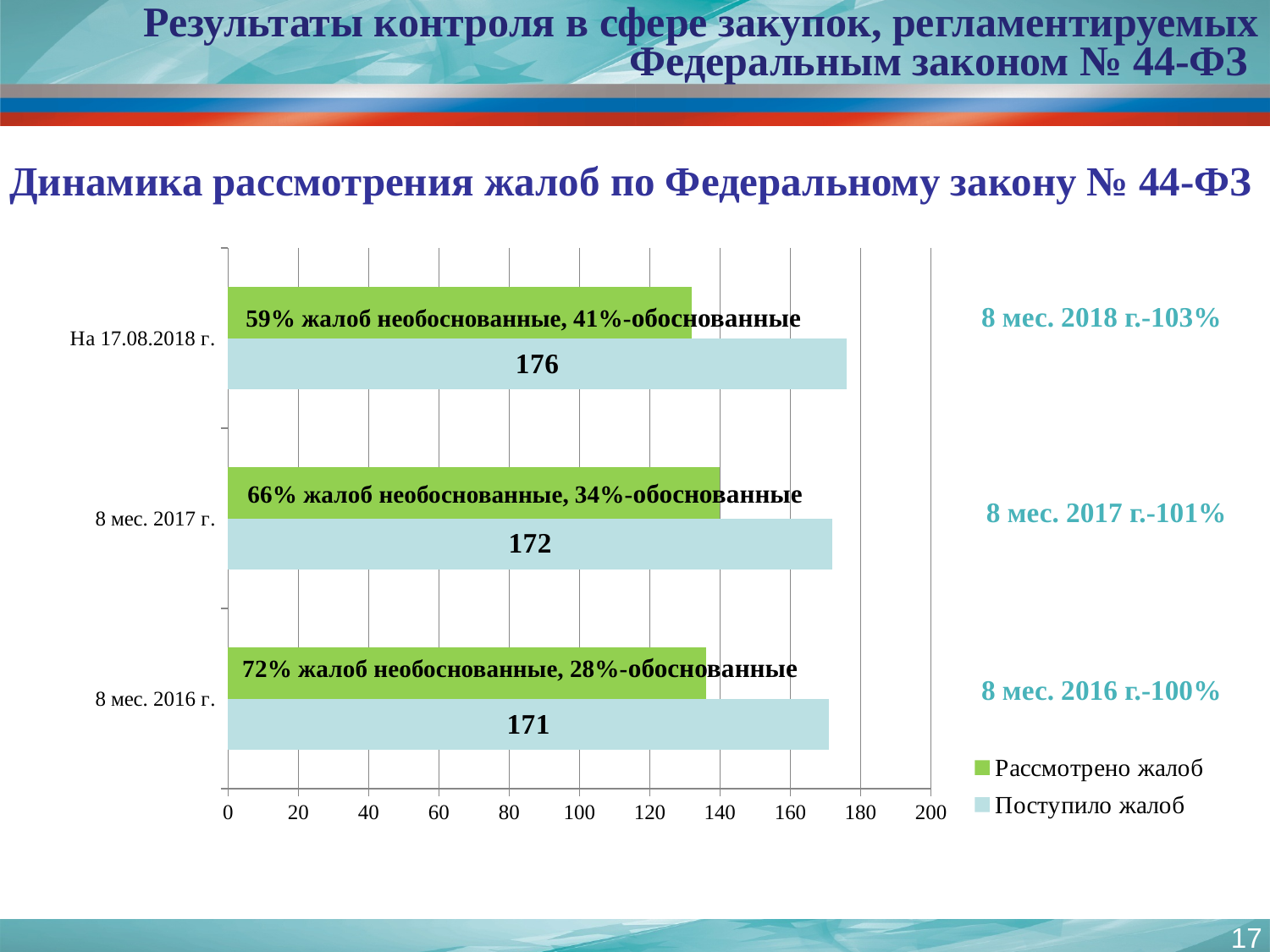
What is the value of Поступило жалоб for На 17.08.2018 г.? 176 Is the value of Рассмотрено жалоб for На 17.08.2018 г. greater or less than 140? less What is the value of Поступило жалоб for 8 мес. 2017 г.? 172 How many categories are shown on the chart? 3 Which category has the lowest value of Поступило жалоб? 8 мес. 2016 г. Is the value of Рассмотрено жалоб for 8 мес. 2016 г. greater or less than 120? greater What is the value of Поступило жалоб for 8 мес. 2016 г.? 171 What kind of chart is shown on the slide? Bar chart What is the difference between Поступило жалоб for На 17.08.2018 г. and for 8 мес. 2016 г.? 5 How many series does the legend list? 2 Which category has the highest value of Поступило жалоб? На 17.08.2018 г. Which is larger: Поступило жалоб for На 17.08.2018 г. or for 8 мес. 2017 г.? На 17.08.2018 г.